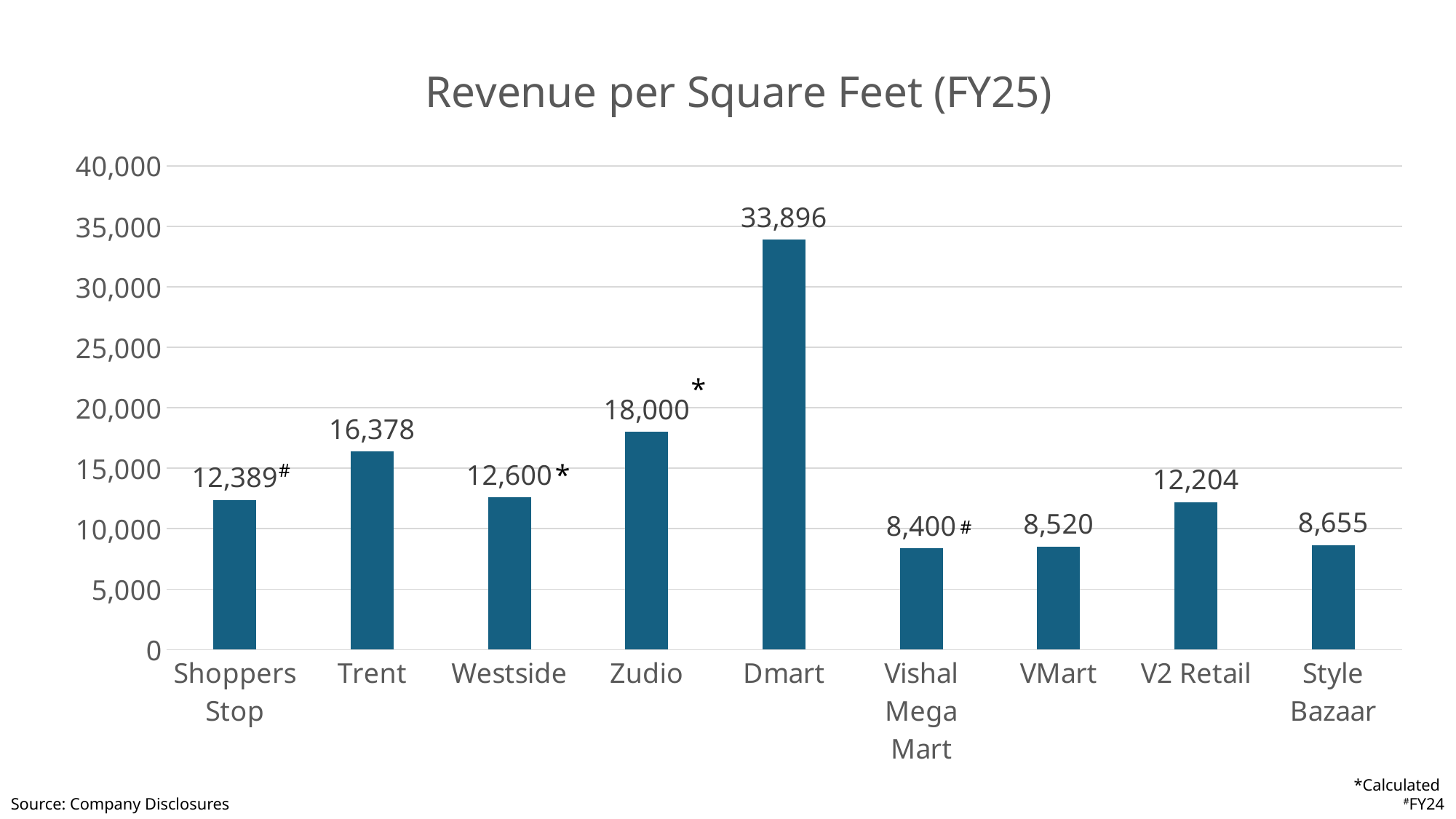
Which company has the lowest revenue per square feet? Vishal Mega Mart Which company has the highest revenue per square feet? Dmart How many companies are shown on the chart? 9 What is the revenue per square feet for Trent? 16,378 What is the revenue per square feet for V2 Retail? 12,204 What is the revenue per square feet for Dmart? 33,896 What is the difference in revenue per square feet between Dmart and Zudio? 15,896 Which has a higher revenue per square feet, Zudio or Trent? Zudio What is the title of the chart? Revenue per Square Feet (FY25) What is the revenue per square feet for Style Bazaar? 8,655 What is the difference in revenue per square feet between Trent and Westside? 3,778 What kind of chart is shown on the slide? Bar chart